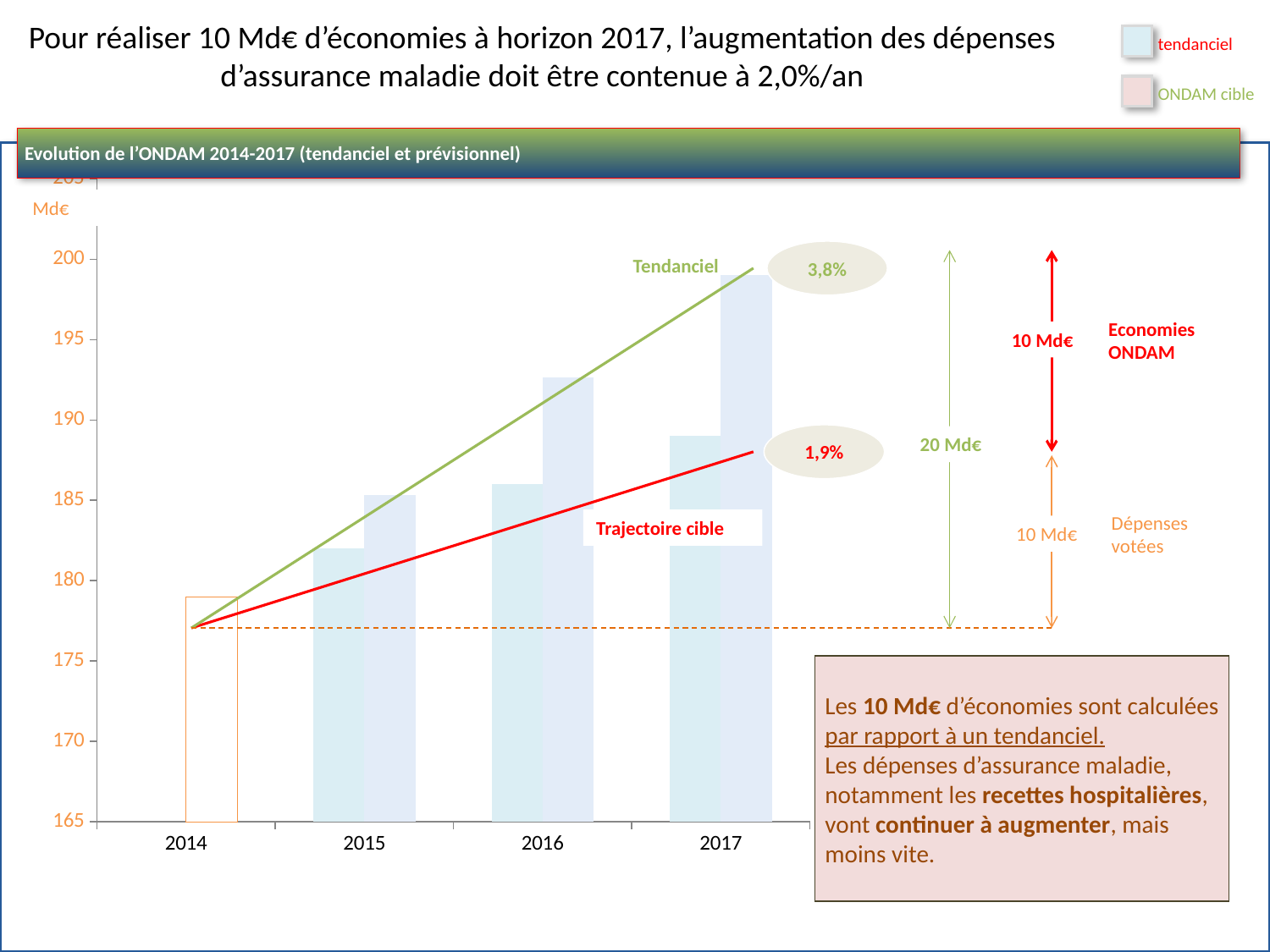
Is the tendanciel bar for 2016 greater or less than 190? greater What annual growth rate is shown for the Trajectoire cible line? 1,9% Is the tendanciel bar for 2017 greater or less than 195? greater Do the tendanciel bars rise or fall from 2015 to 2017? rise How many series does the legend list? 2 How many years are shown on the x axis of the chart? 4 What unit is shown on the y axis of the chart? Md€ What is the title of the chart? Evolution de l'ONDAM 2014-2017 (tendanciel et prévisionnel) Is the ONDAM cible bar for 2015 greater or less than 185? less For 2017, which bar is taller: tendanciel or ONDAM cible? tendanciel What annual growth rate is shown for the Tendanciel line? 3,8% What kind of chart is shown on the slide? bar chart